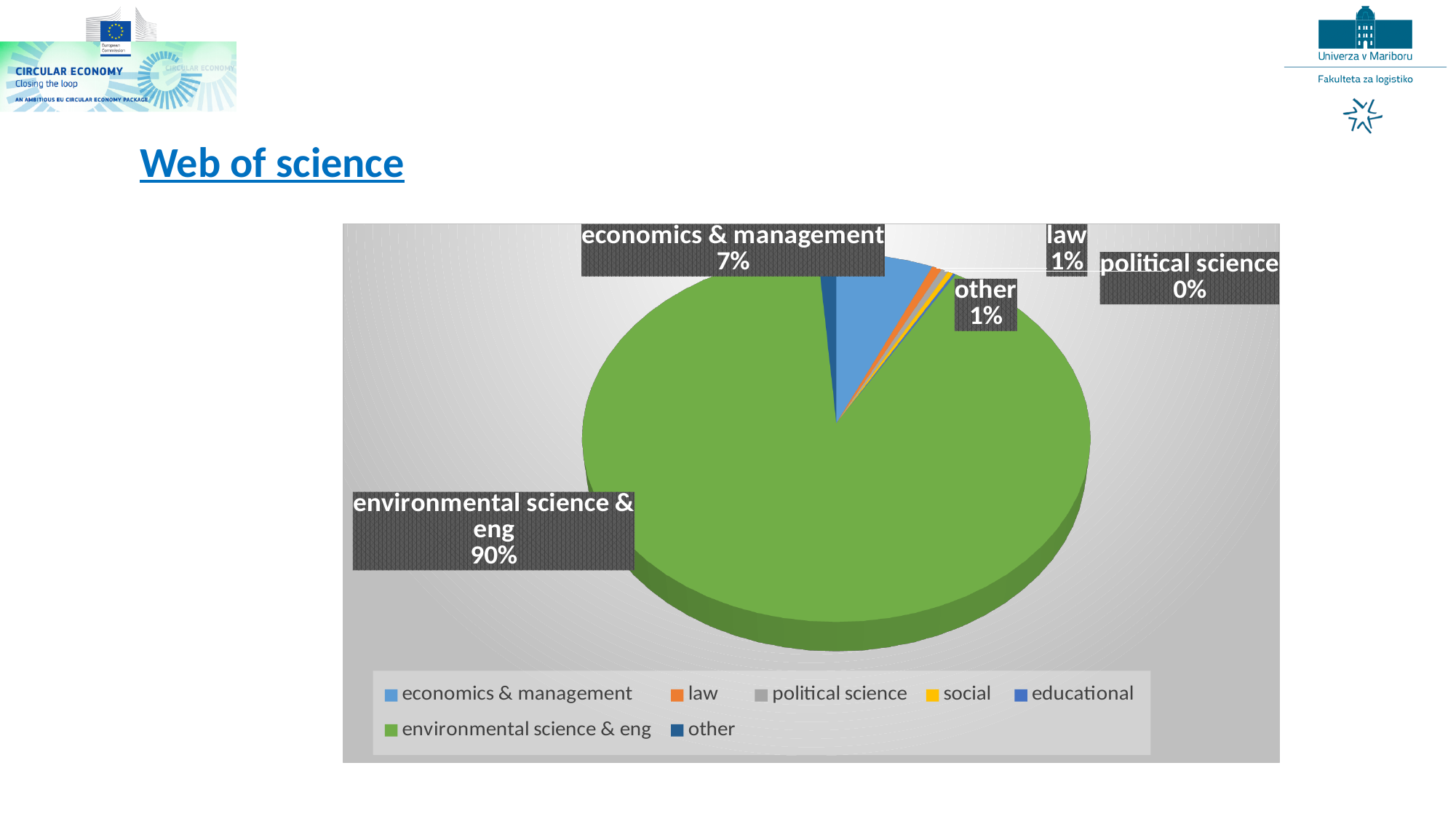
Which is larger, the slice for economics & management or the slice for law? economics & management What colour is the environmental science & eng slice? green What share of the pie does environmental science & eng have? 90% What share of the pie does law have? 1% What share of the pie does economics & management have? 7% What is the difference in percentage points between environmental science & eng and economics & management? 83% How many categories does the legend list? 7 What kind of chart is shown on the slide? pie chart What is the title of the slide above the chart? Web of science What share of the pie does the 'other' category have? 1% What share of the pie does political science have? 0% Which category has the largest slice of the pie? environmental science & eng